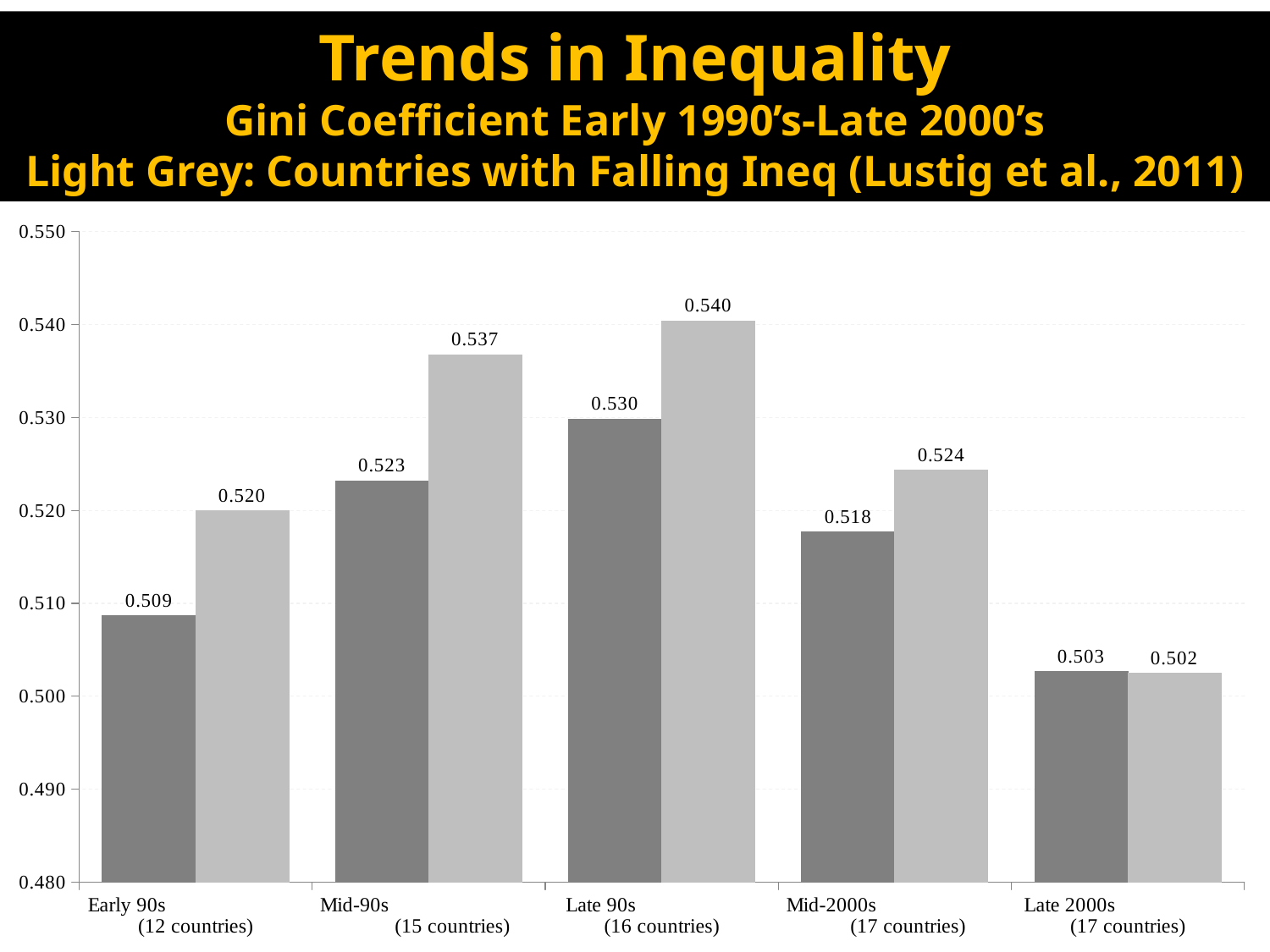
Is the light grey bar value for Mid-2000s greater or less than 0.520? greater What is the dark grey bar value for Mid-2000s? 0.518 Which is larger for Early 90s, the dark grey bar or the light grey bar? light grey bar How many period categories are shown on the x axis? 5 How many countries are included in the Late 90s category? 16 countries What is the difference between the light grey and dark grey bars for Mid-90s? 0.014 According to the slide title, what do the light grey bars represent? Countries with Falling Ineq What type of chart is shown on the slide? bar chart Which period has the highest light grey bar? Late 90s What is the dark grey bar value for Early 90s? 0.509 What is the light grey bar value for Late 90s? 0.540 Which period has the lowest dark grey bar? Late 2000s